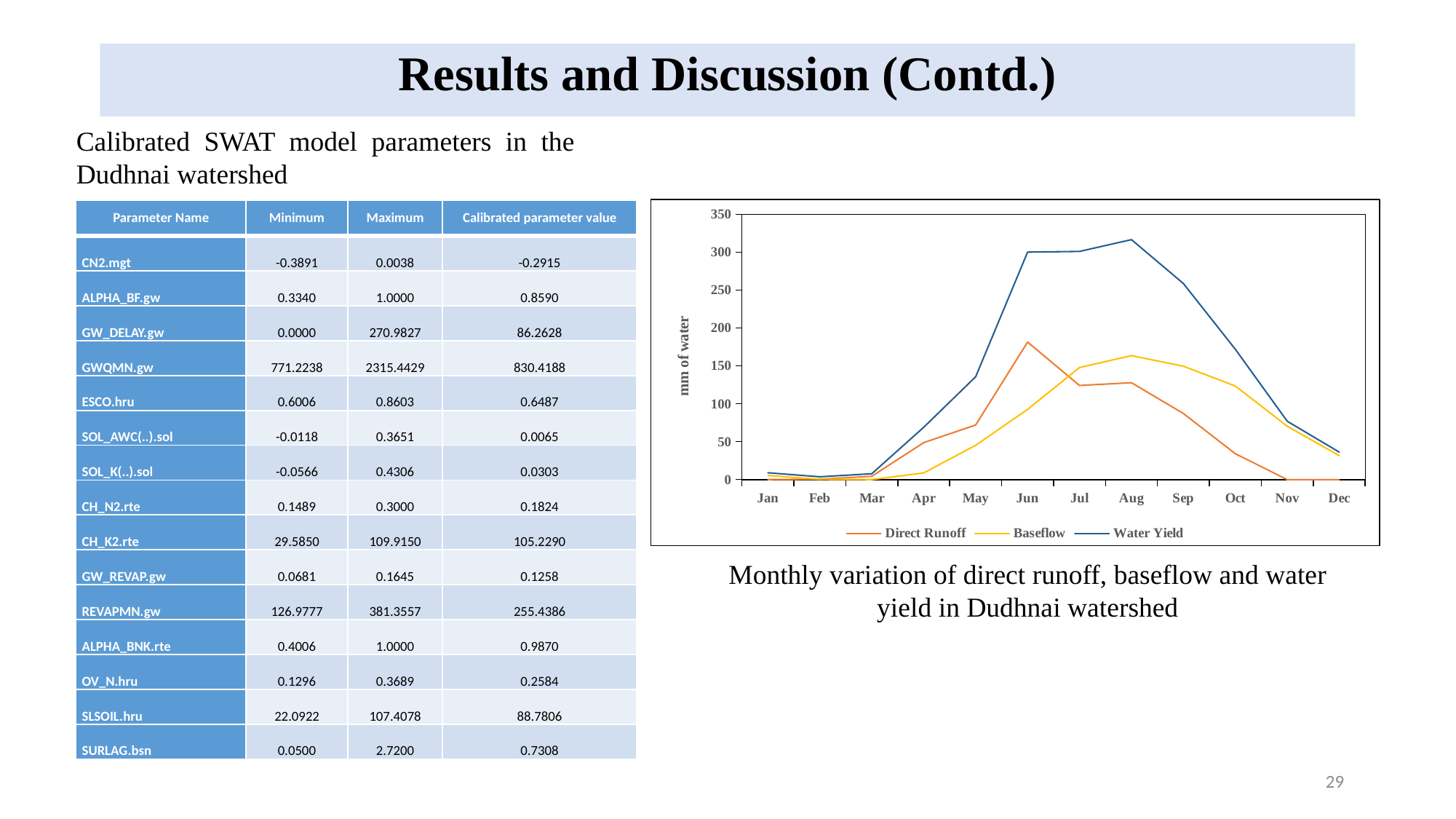
What kind of chart is shown on the slide? line chart In which month does the Direct Runoff series reach its highest value? Jun In Jun, which series has the larger value: Direct Runoff or Baseflow? Direct Runoff In which month does the Water Yield series reach its highest value? Aug Is the Water Yield value for Oct greater or less than 200? less What is the label on the y axis of the chart? mm of water Is the Water Yield value for Aug greater or less than 250? greater How many series does the chart legend list? 3 How many months are plotted along the x axis of the chart? 12 Is the Direct Runoff value for Jun greater or less than 150? greater Does the Water Yield series rise or fall from Aug to Dec? fall